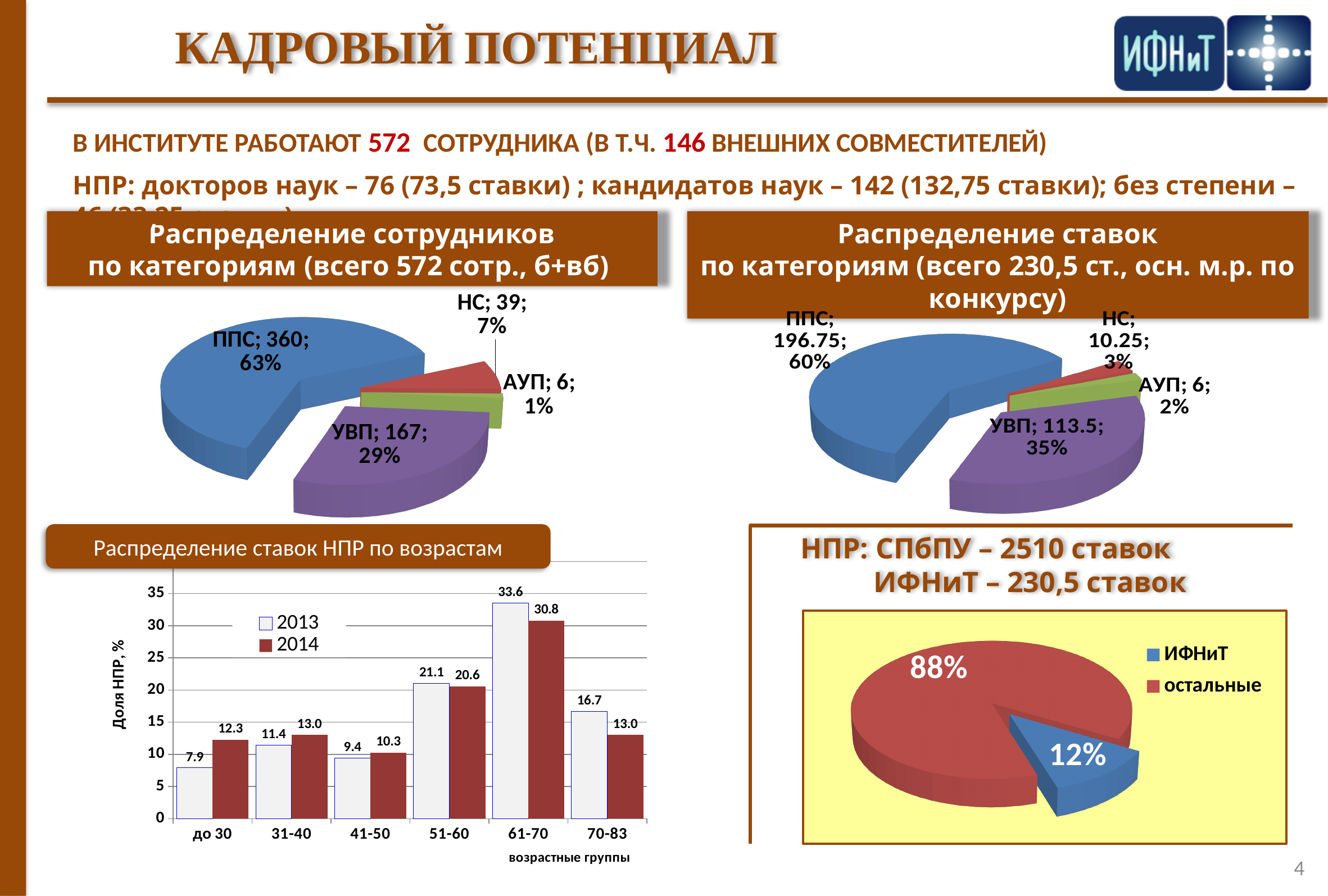
In the bottom-left chart 'Распределение ставок НПР по возрастам', what is the difference between the 2013 and 2014 values for the 70-83 age group? 3.7 In the top-right pie chart 'Распределение ставок по категориям', how many categories are shown? 4 In the bottom-left chart 'Распределение ставок НПР по возрастам', what is the 2013 value for the 'до 30' age group? 7.9 In the bottom-left chart 'Распределение ставок НПР по возрастам', which age group has the highest 2013 value? 61-70 In the top-right pie chart 'Распределение ставок по категориям', what share do НС rates represent? 3% In the bottom-right pie chart, what share does ИФНиТ represent? 12% In the top-left pie chart 'Распределение сотрудников по категориям', which category has the smallest number of employees? АУП In the top-left pie chart 'Распределение сотрудников по категориям', how many employees are in the ППС category? 360 In the top-right pie chart 'Распределение ставок по категориям', what is the value for ППС? 196.75 In the top-left pie chart 'Распределение сотрудников по категориям', what share of employees does УВП represent? 29% In the bottom-left chart 'Распределение ставок НПР по возрастам', how many series does the legend list? 2 In the bottom-left chart 'Распределение ставок НПР по возрастам', what is the 2014 value for the 61-70 age group? 30.8